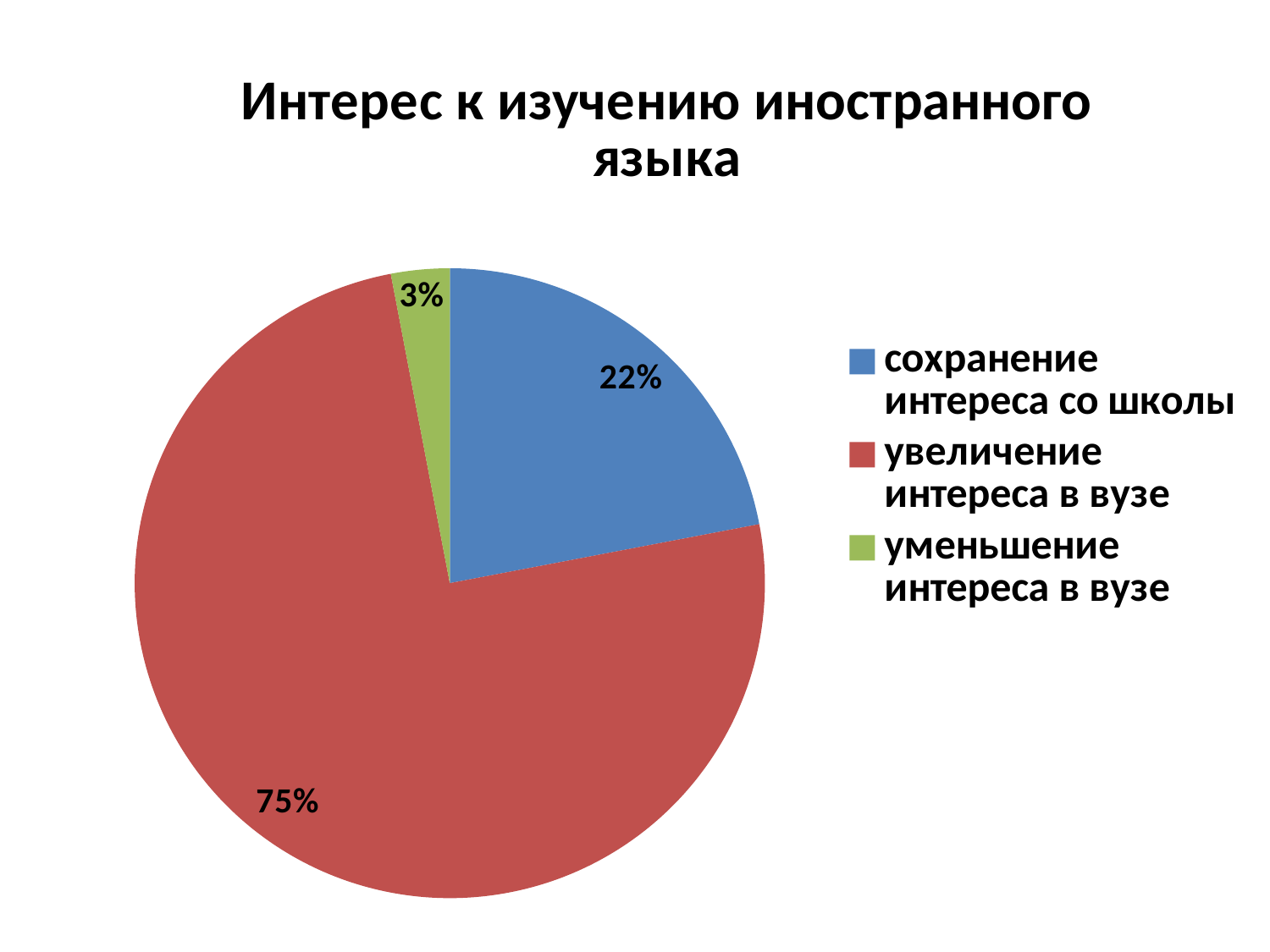
What is the title of the chart? Интерес к изучению иностранного языка What colour is the slice for 'уменьшение интереса в вузе'? green Which category has the largest slice of the pie? увеличение интереса в вузе Which category has the smallest slice of the pie? уменьшение интереса в вузе What share of the pie is labelled 'сохранение интереса со школы'? 22% What is the difference between the shares for 'увеличение интереса в вузе' and 'сохранение интереса со школы'? 53% How many categories does the pie chart show? 3 Which is larger: the share for 'сохранение интереса со школы' or the share for 'уменьшение интереса в вузе'? сохранение интереса со школы What is the difference between the shares for 'сохранение интереса со школы' and 'уменьшение интереса в вузе'? 19% What share of the pie is labelled 'увеличение интереса в вузе'? 75% What kind of chart is shown on the slide? pie chart What share of the pie is labelled 'уменьшение интереса в вузе'? 3%